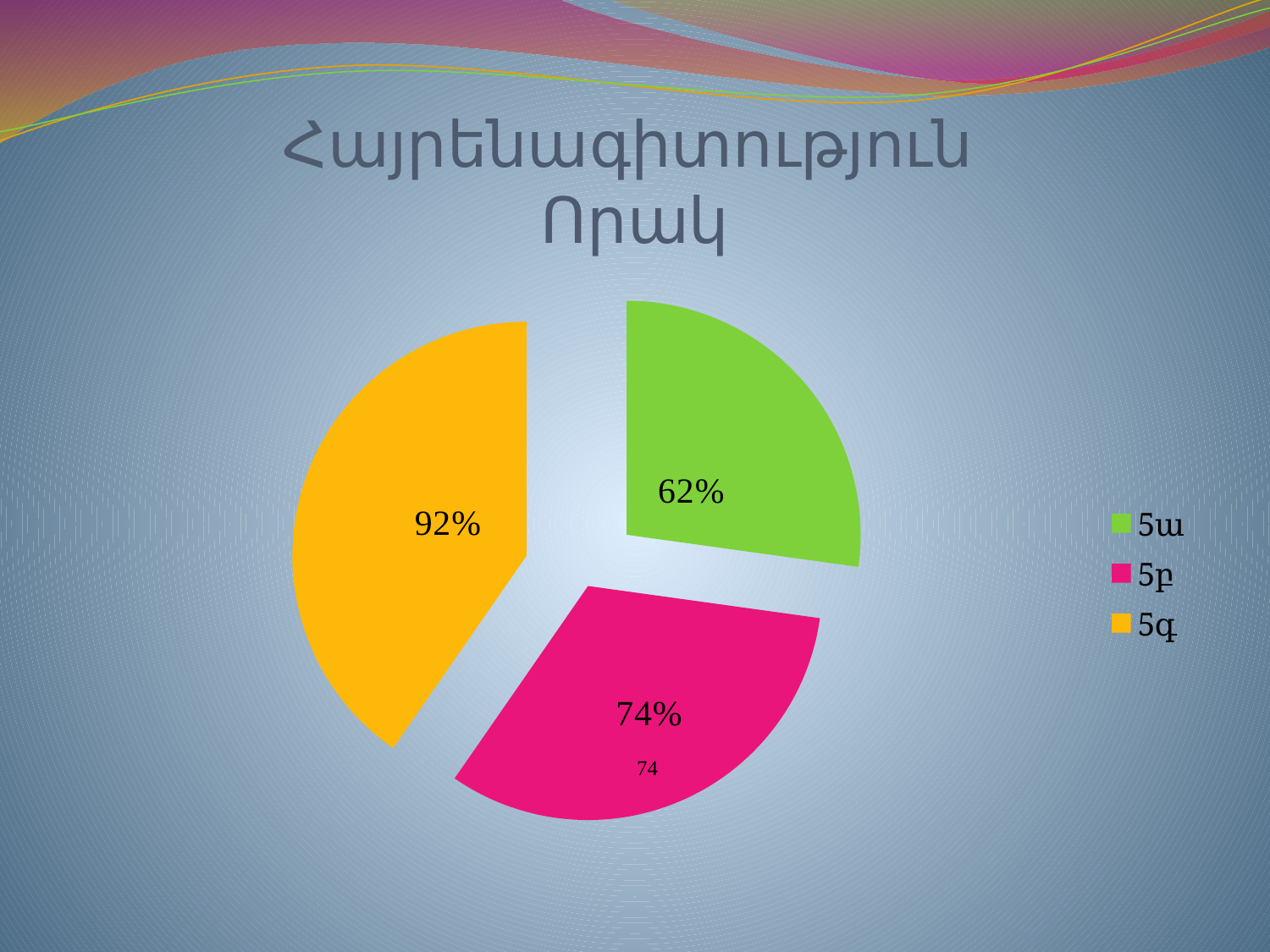
What is the value shown for 5գ? 92% What type of chart is shown on the slide? pie chart What is the difference between the values for 5գ and 5ա? 30% How many slices does the pie chart have? 3 Which category has the lowest value? 5ա What is the value shown for 5բ? 74% What is the value shown for 5ա? 62% Which category has the highest value? 5գ What is the difference between the values for 5բ and 5ա? 12% What colour is the slice for 5գ? yellow Which has a larger value, 5բ or 5ա? 5բ How many entries does the legend list? 3